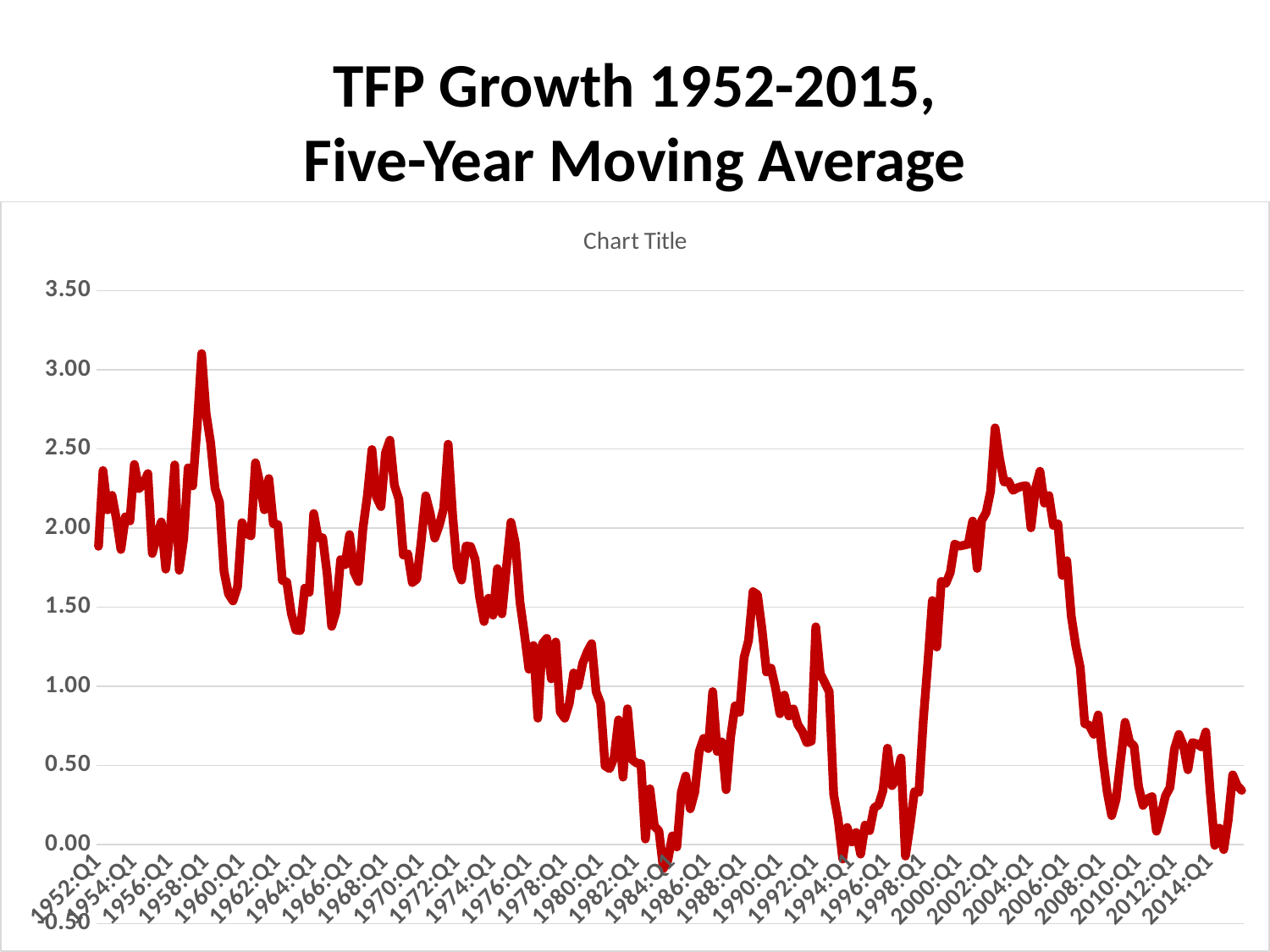
Is the value at 1958:Q1 greater or less than 2.50? greater What colour is the plotted line? Red Is the value at 1984:Q1 greater or less than 0.50? less What is the title shown at the top of the slide above the chart? TFP Growth 1952-2015, Five-Year Moving Average Is the value at 1996:Q1 greater or less than 0.50? greater Which is larger, the value at 2002:Q1 or the value at 2014:Q1? 2002:Q1 Overall, do the values rise or fall from 1952 to 2015? Fall What kind of chart is shown on the slide? Line chart Which is larger, the value at 1958:Q1 or the value at 1984:Q1? 1958:Q1